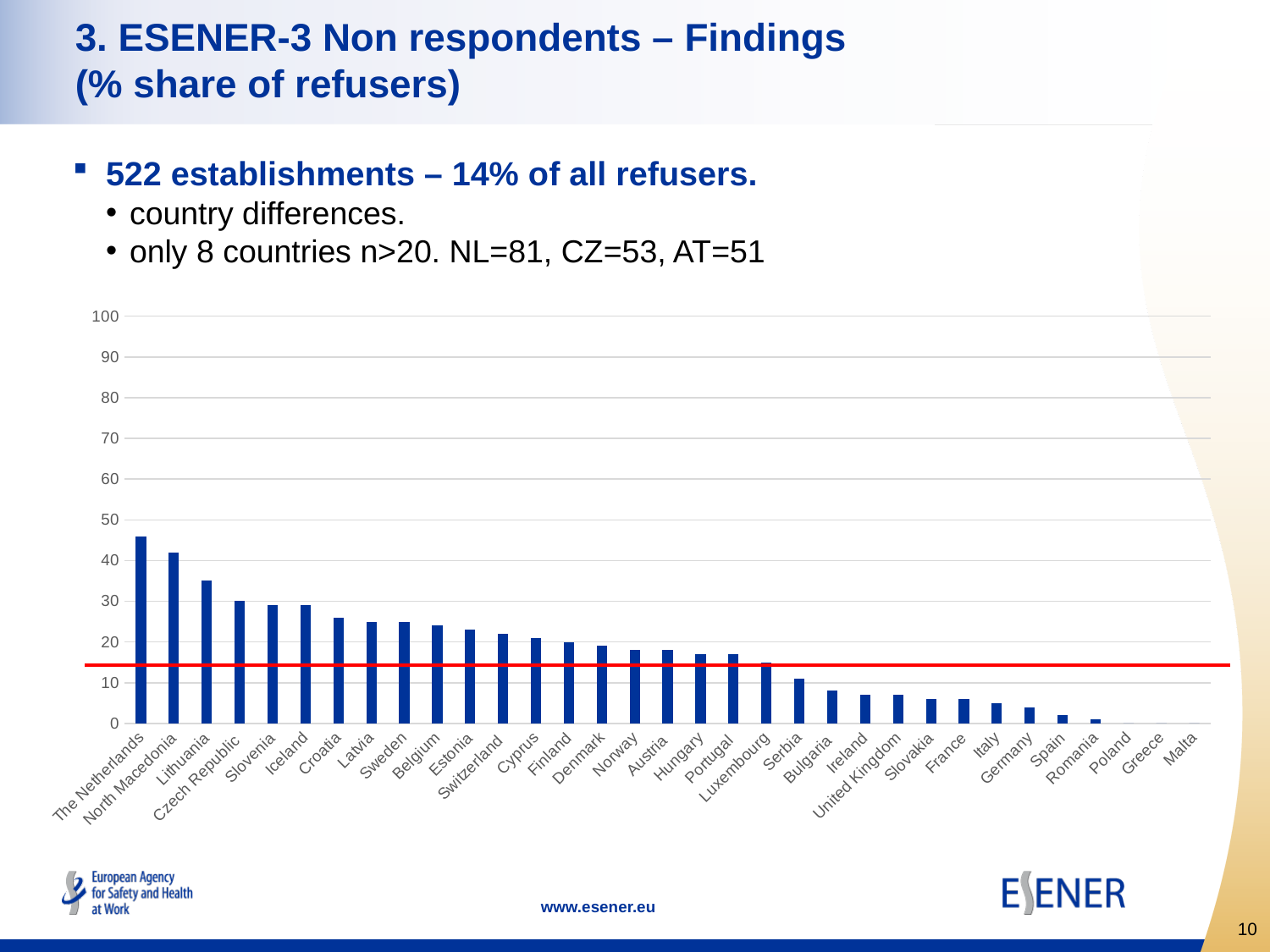
What is the highest value shown on the chart's vertical axis? 100 Is the value for Lithuania greater or less than 30? greater What kind of chart is shown on the slide? Bar chart Is the value for The Netherlands greater or less than 40? greater How many countries are listed on the x axis of the chart? 33 Which has the larger value, Croatia or Serbia? Croatia Which has the larger value, Belgium or Germany? Belgium Do the bar values rise or fall from left to right along the x axis? Fall Which country has the highest share of refusers in the chart? The Netherlands Is the value for Croatia greater or less than 20? greater